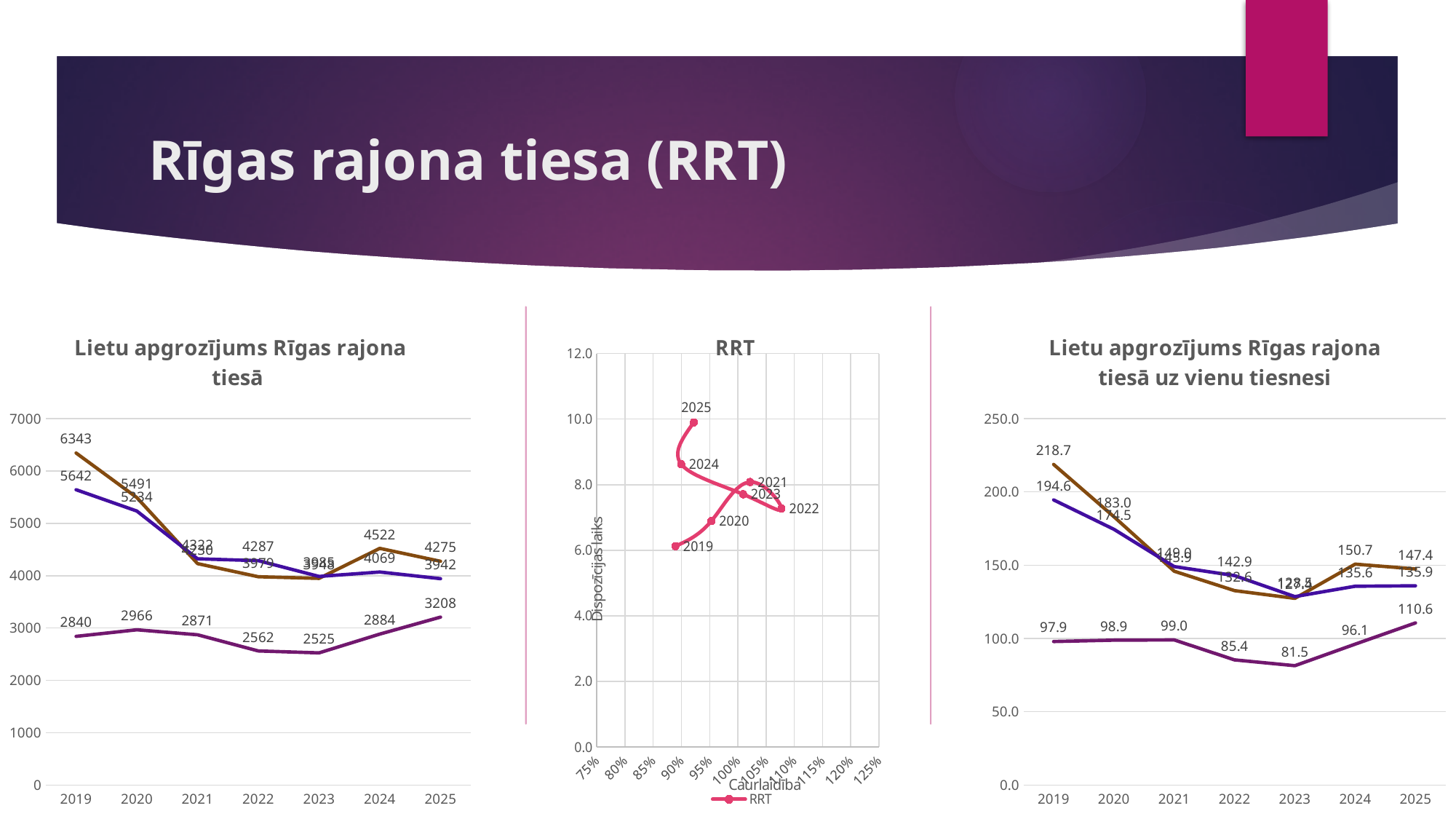
How many years are shown on the x axis of the chart titled "Lietu apgrozījums Rīgas rajona tiesā"? 7 In the chart titled "Lietu apgrozījums Rīgas rajona tiesā uz vienu tiesnesi", which is larger for the purple line: the 2022 value or the 2024 value? 2024 In the middle chart titled "RRT", is the Dispozīcijas laiks value for 2025 greater or less than 8.0? greater In the chart titled "Lietu apgrozījums Rīgas rajona tiesā", what is the difference between the purple line's 2025 value and its 2023 value? 683 What kind of chart is the chart titled "Lietu apgrozījums Rīgas rajona tiesā uz vienu tiesnesi"? line chart In the chart titled "Lietu apgrozījums Rīgas rajona tiesā", what is the value of the top (brown) line in 2019? 6343 In the chart titled "Lietu apgrozījums Rīgas rajona tiesā", in which year does the lowest (purple) line reach its lowest value? 2023 In the chart titled "Lietu apgrozījums Rīgas rajona tiesā uz vienu tiesnesi", what is the difference between the purple line's 2025 value and its 2023 value? 29.1 In the chart titled "Lietu apgrozījums Rīgas rajona tiesā", in which year does the lowest (purple) line reach its highest value? 2025 How many series does the legend of the middle chart titled "RRT" list? 1 In the chart titled "Lietu apgrozījums Rīgas rajona tiesā", what is the value of the lowest (purple) line in 2019? 2840 In the chart titled "Lietu apgrozījums Rīgas rajona tiesā uz vienu tiesnesi", what is the value of the lowest (purple) line in 2023? 81.5